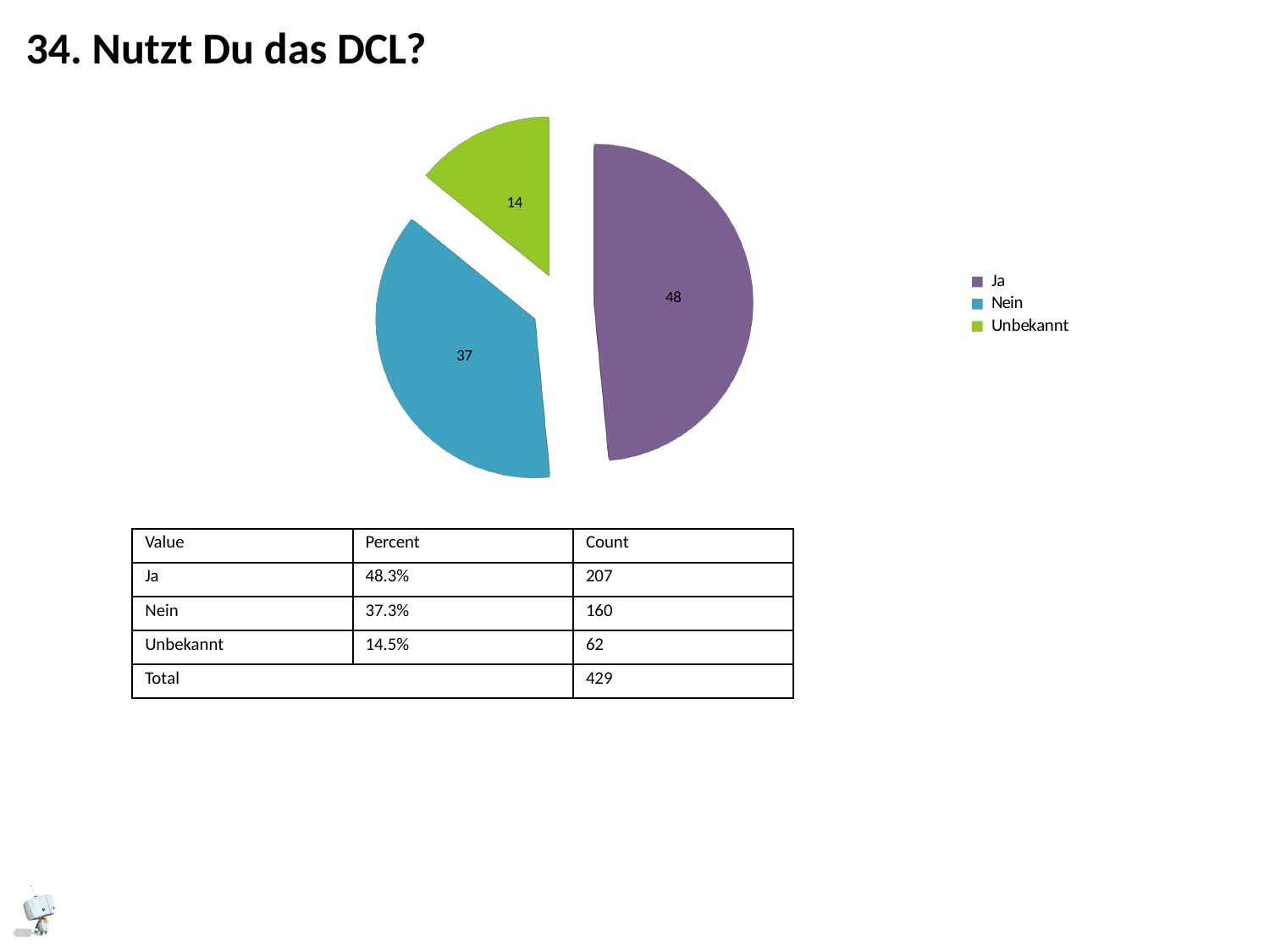
What kind of chart is shown on the slide? pie chart What is the difference between the labelled values of the Nein and Unbekannt slices? 23 How many slices does the pie chart have? 3 What colour is the Unbekannt slice in the pie chart? green Which category has the smallest slice in the pie chart? Unbekannt What value is labelled on the Nein slice of the pie chart? 37 Which category has the largest slice in the pie chart? Ja Which slice is larger, Nein or Unbekannt? Nein What value is labelled on the Unbekannt slice of the pie chart? 14 What is the difference between the labelled values of the Ja and Nein slices? 11 How many entries does the legend list? 3 What value is labelled on the Ja slice of the pie chart? 48